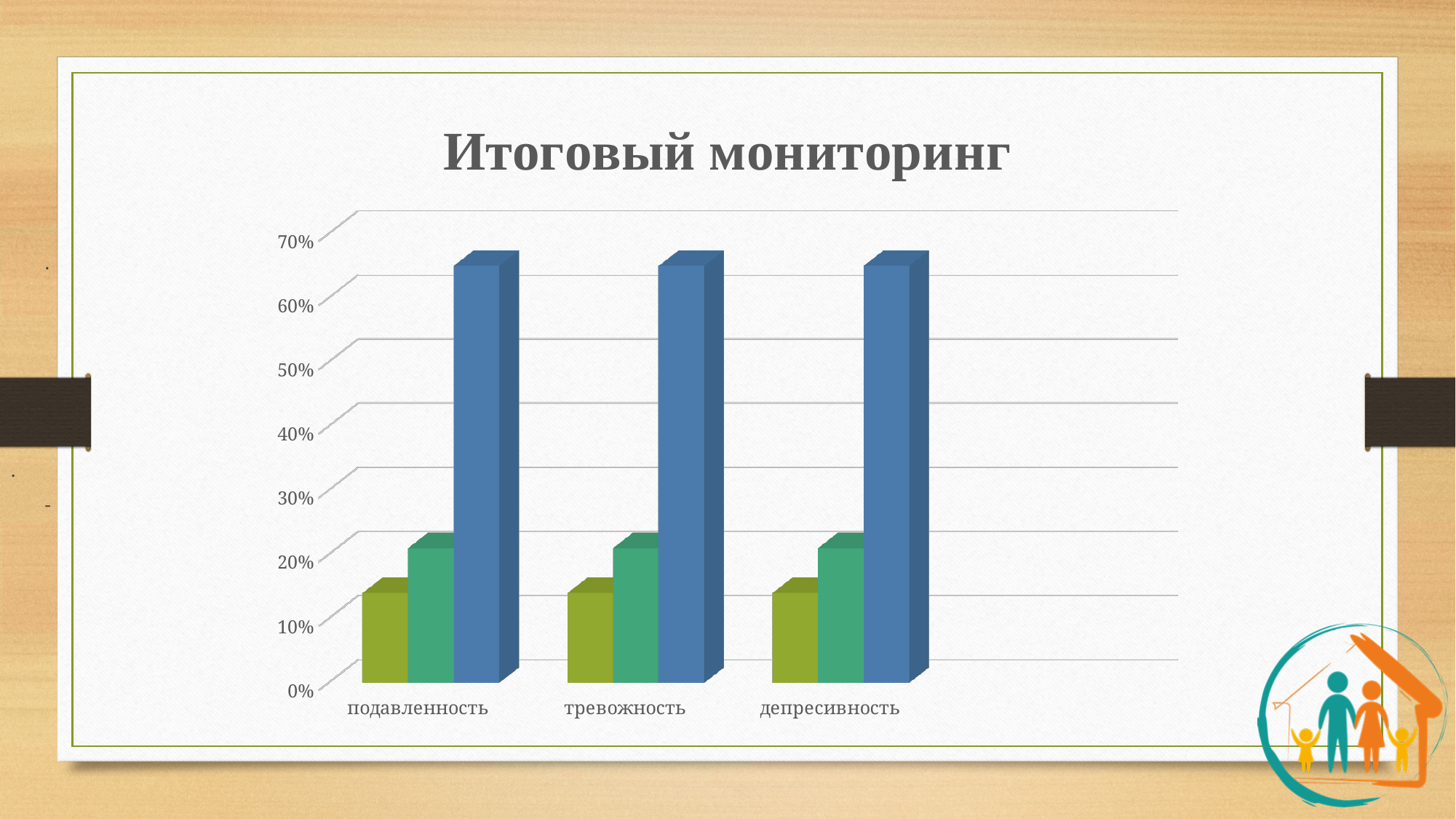
How many bars are plotted for each category in the chart? 3 Is the value of the blue bar for тревожность greater or less than 60%? greater How many categories are shown on the x axis of the chart? 3 What is the highest value labelled on the vertical axis of the chart? 70% For the category депресивность, which is larger: the blue bar or the olive green bar? the blue bar Is the value of the blue bar for подавленность greater or less than 70%? less Is the value of the teal green bar for подавленность greater or less than 30%? less Which coloured bar is the shortest for the category тревожность? the olive green bar What is the title of the chart? Итоговый мониторинг Which coloured bar is the tallest for the category подавленность? the blue bar What kind of chart is shown on the slide? bar chart